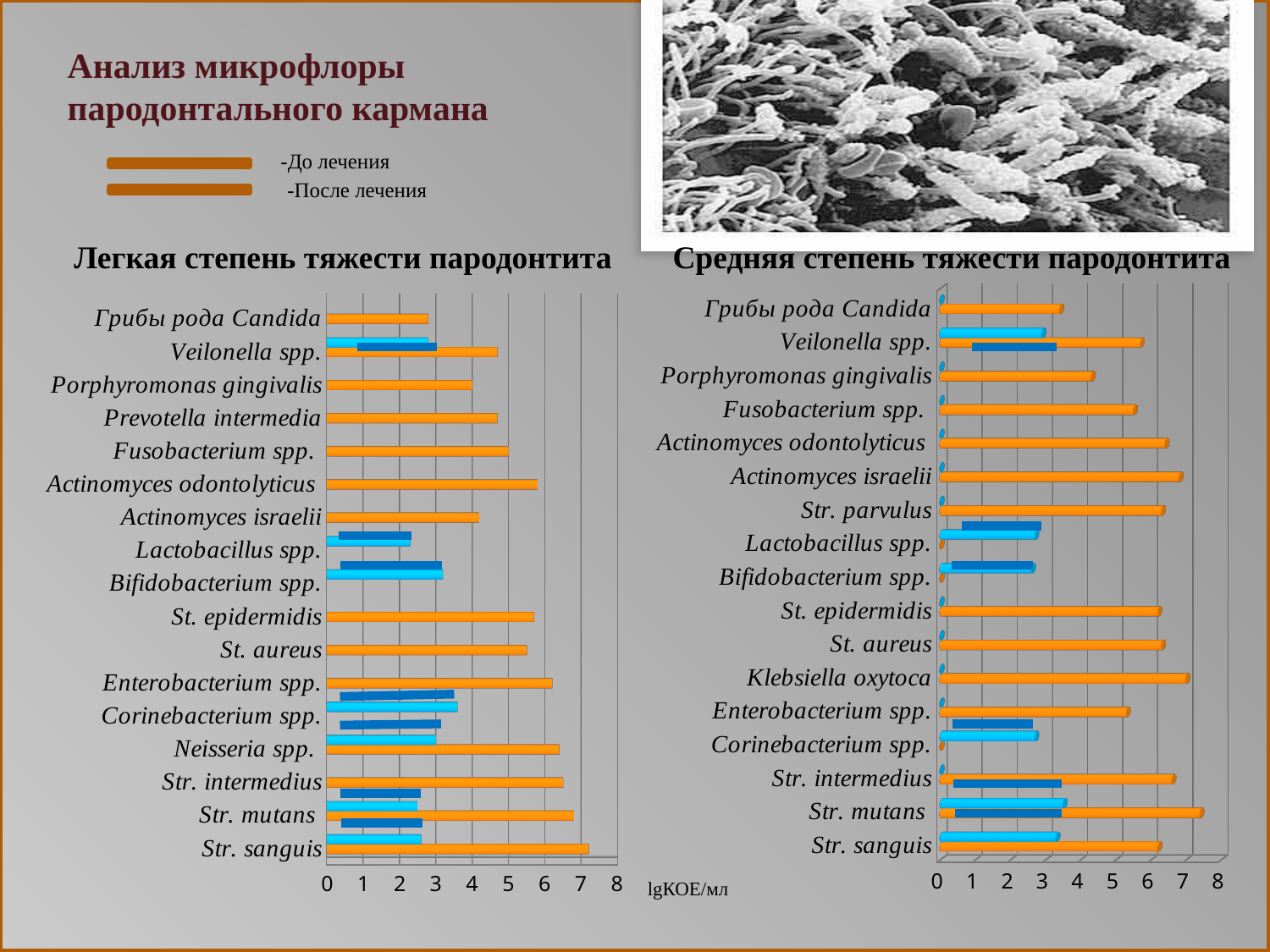
On the "Легкая степень тяжести пародонтита" chart, which has the longer orange bar: Actinomyces odontolyticus or Actinomyces israelii? Actinomyces odontolyticus On the "Легкая степень тяжести пародонтита" chart, which category has the longest orange bar? Str. sanguis On the "Средняя степень тяжести пародонтита" chart, is the orange bar for Грибы рода Candida greater or less than 4? less What unit label is shown next to the x axis of the left chart? lgKOE/мл How many categories are plotted on the "Легкая степень тяжести пародонтита" chart? 17 How many categories are plotted on the "Средняя степень тяжести пародонтита" chart? 17 On the "Легкая степень тяжести пародонтита" chart, is the orange bar for Str. sanguis greater or less than 6? greater What kind of chart is the "Легкая степень тяжести пародонтита" chart? bar chart On the "Средняя степень тяжести пародонтита" chart, which category has the longest orange bar? Str. mutans On the "Средняя степень тяжести пародонтита" chart, is the orange bar for Str. mutans greater or less than 7? greater How many entries does the legend at the top left of the slide list? 2